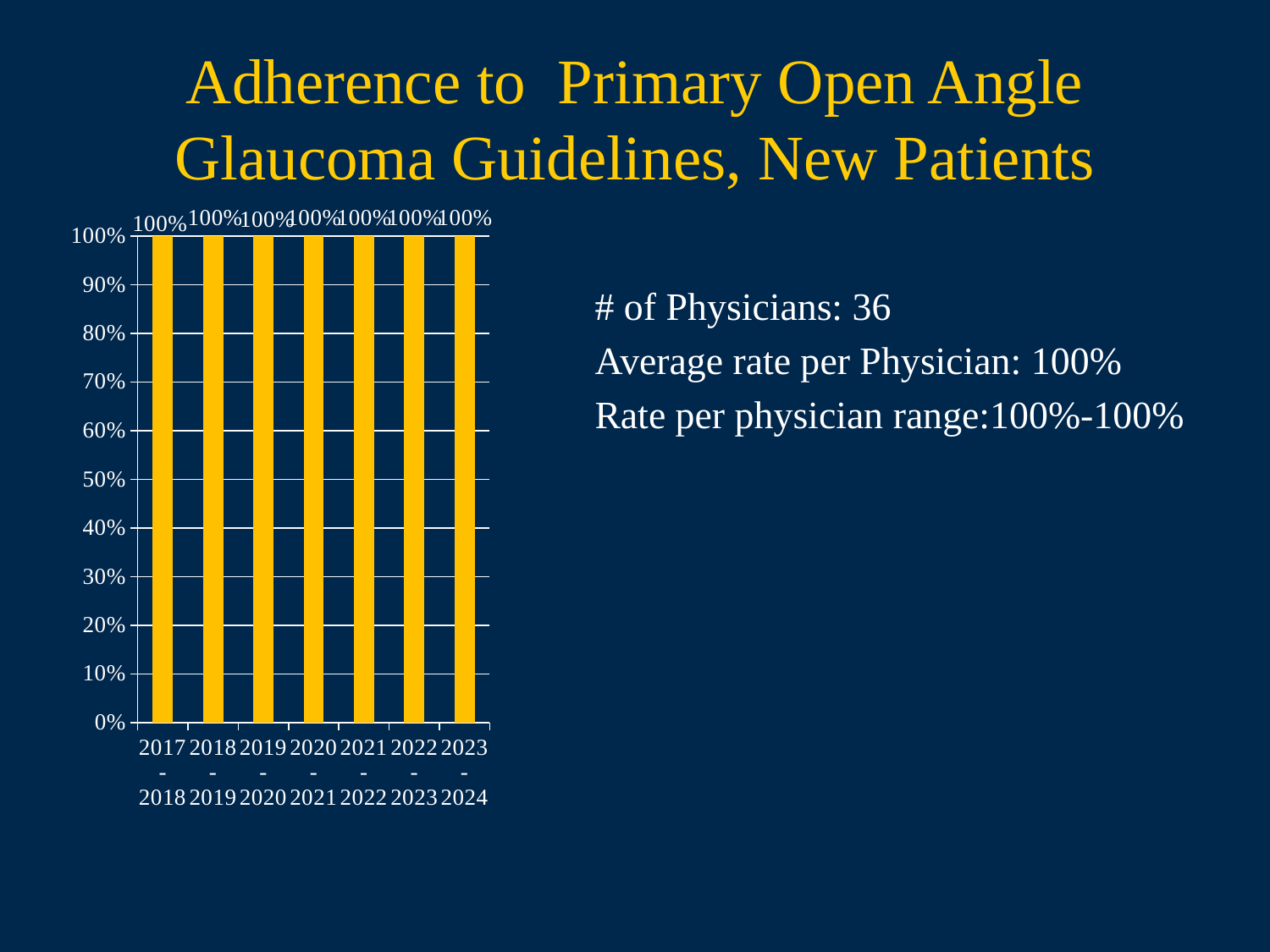
What is the value for 2023-2024? 100% What colour are the bars? yellow Do the values rise, fall, or stay the same from 2017-2018 to 2023-2024? stay the same What is the difference between the values for 2019-2020 and 2022-2023? 0% What is the value for 2020-2021? 100% What kind of chart is shown? bar chart What is the first period shown on the x axis? 2017-2018 How many periods are shown on the x axis? 7 Is the value for 2021-2022 greater or less than 50%? greater What is the value for 2017-2018? 100%